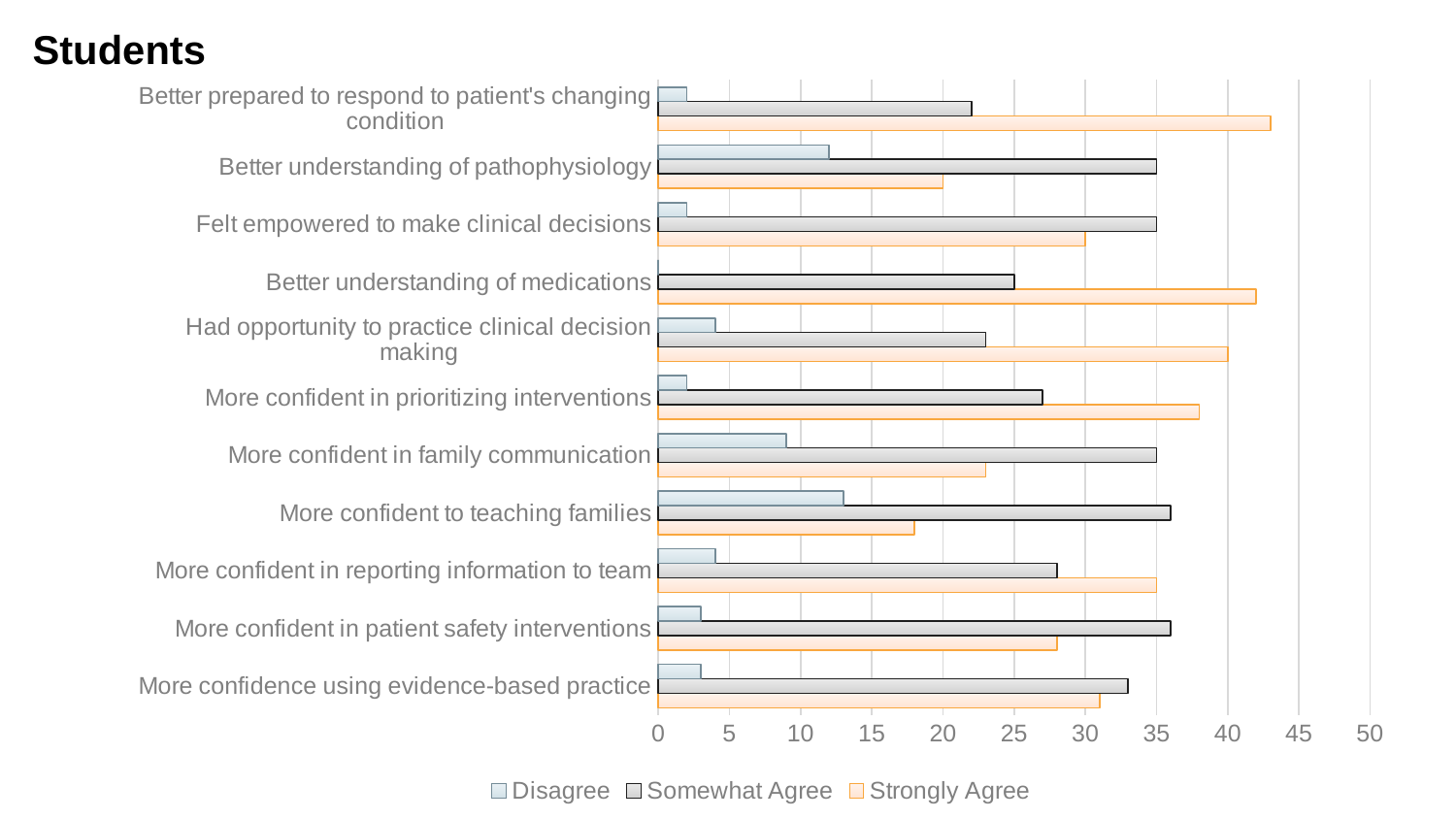
What kind of chart is shown on the slide? Bar chart What are the three series named in the legend? Disagree, Somewhat Agree, Strongly Agree Is the Disagree value for "Better understanding of pathophysiology" greater or less than 10? greater For "Better understanding of pathophysiology", which is larger: Somewhat Agree or Strongly Agree? Somewhat Agree Is the Strongly Agree value for "More confident to teaching families" greater or less than 20? less Which has the larger Strongly Agree value: "Felt empowered to make clinical decisions" or "More confident in family communication"? Felt empowered to make clinical decisions Which has the larger Disagree value: "More confident to teaching families" or "Better prepared to respond to patient's changing condition"? More confident to teaching families Is the Strongly Agree value for "Better prepared to respond to patient's changing condition" greater or less than 40? greater How many categories (statements) are plotted on the chart? 11 Which category has the lowest Disagree value? Better understanding of medications How many series does the legend list? 3